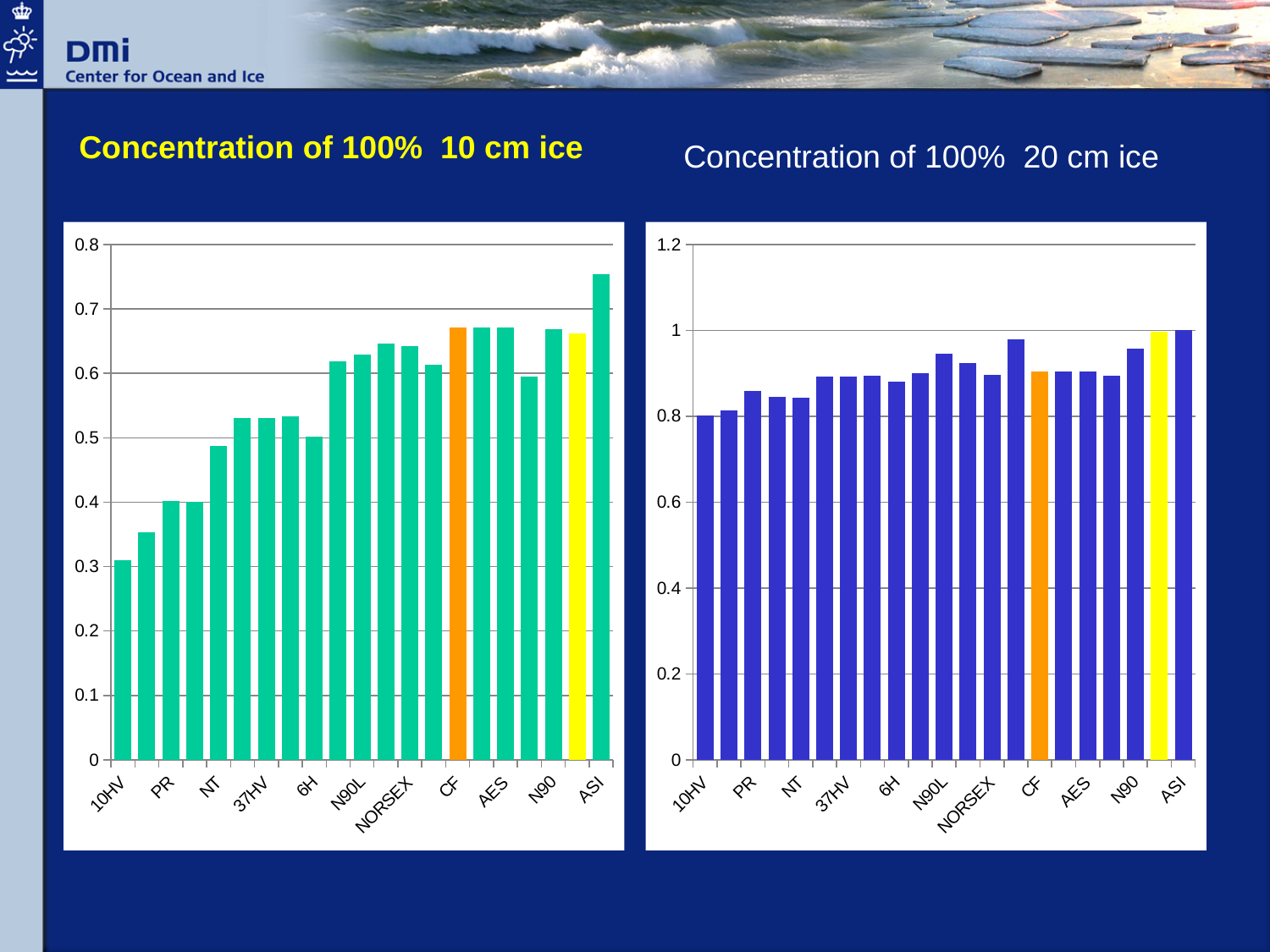
What kind of chart is the 'Concentration of 100% 10 cm ice' chart on the left? bar chart In the 'Concentration of 100% 10 cm ice' chart, which is larger, the value for CF or the value for NT? CF In the 'Concentration of 100% 10 cm ice' chart, is the value for ASI greater or less than 0.7? greater In the 'Concentration of 100% 10 cm ice' chart, do the values generally rise or fall from left to right along the x axis? rise In the 'Concentration of 100% 20 cm ice' chart, is the value for CF greater or less than 0.8? greater In the 'Concentration of 100% 10 cm ice' chart, what colour is the bar for CF? orange In the 'Concentration of 100% 10 cm ice' chart, is the value for CF greater or less than 0.6? greater In the 'Concentration of 100% 10 cm ice' chart, which category has the highest value? ASI In the 'Concentration of 100% 20 cm ice' chart, which is larger, the value for ASI or the value for 10HV? ASI In the 'Concentration of 100% 10 cm ice' chart, which category has the lowest value? 10HV